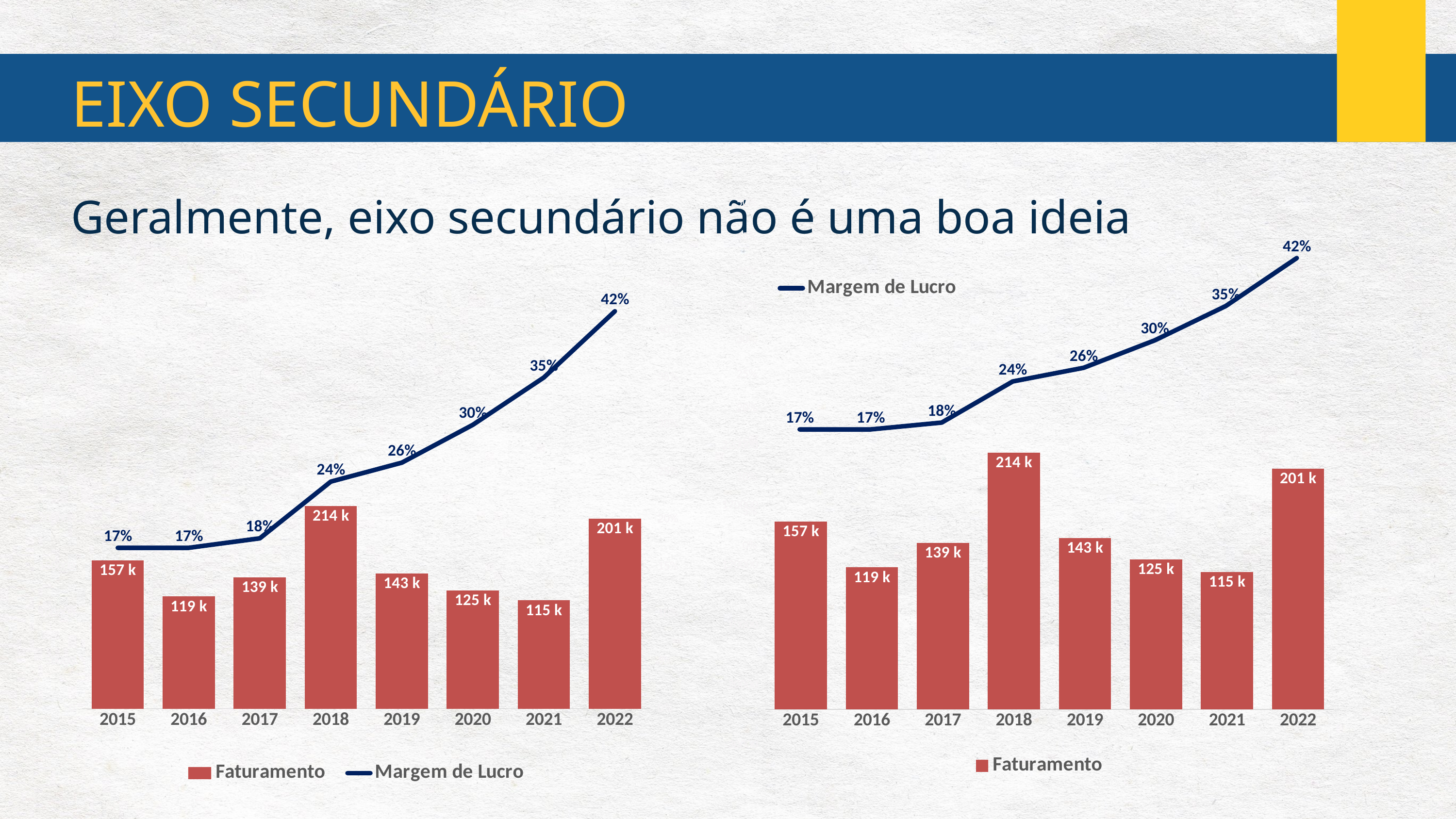
In the left chart, what is the difference in Faturamento between 2018 and 2021? 99 k In the left chart, which year has the lowest Faturamento? 2021 In the left chart, how many years are shown on the x axis? 8 In the left chart, what is the Margem de Lucro for 2020? 30% How many series does the legend of the left chart list? 2 In the right-hand charts, what is the Faturamento value for 2021? 115 k In the left chart, does the Margem de Lucro rise or fall from 2015 to 2022? rise In the right-hand charts, is the Faturamento for 2015 or 2019 larger? 2015 In the left chart, what is the difference in Margem de Lucro between 2022 and 2015? 25 percentage points In the left chart, which year has the highest Faturamento? 2018 In the right-hand charts, which year has the highest Margem de Lucro? 2022 In the left chart, what is the Faturamento value for 2018? 214 k